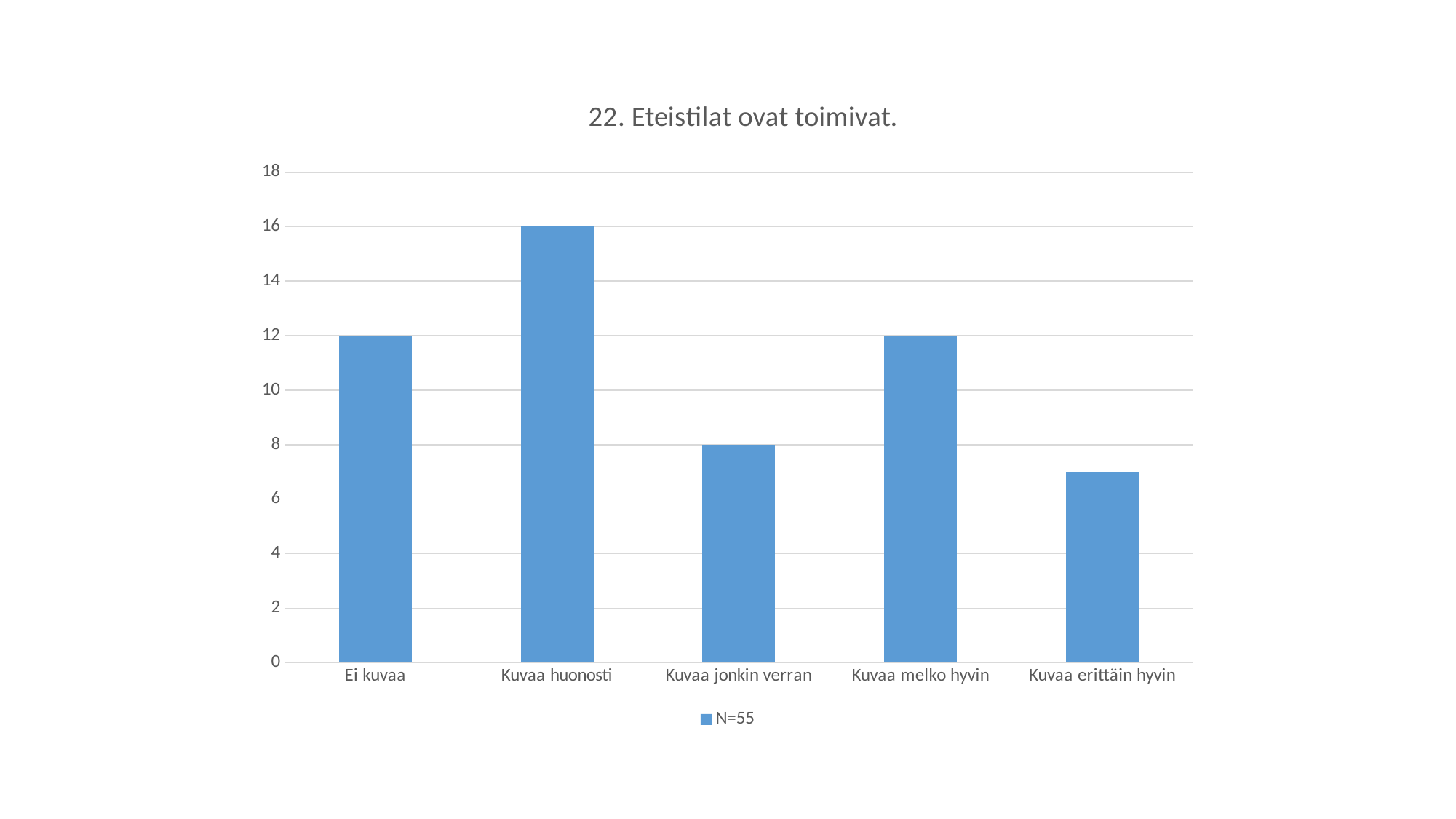
How many series does the legend list? 1 Which category has the highest value? Kuvaa huonosti What is the difference between the values for Kuvaa huonosti and Kuvaa jonkin verran? 8 How many categories are shown on the x axis? 5 What is the value for Kuvaa jonkin verran? 8 Is the value for Kuvaa erittäin hyvin greater or less than 8? less Which category has the lowest value? Kuvaa erittäin hyvin What is the title of the chart? 22. Eteistilat ovat toimivat. What is the legend entry for the series? N=55 What type of chart is shown on the slide? bar chart What is the value for Kuvaa huonosti? 16 What is the value for Ei kuvaa? 12